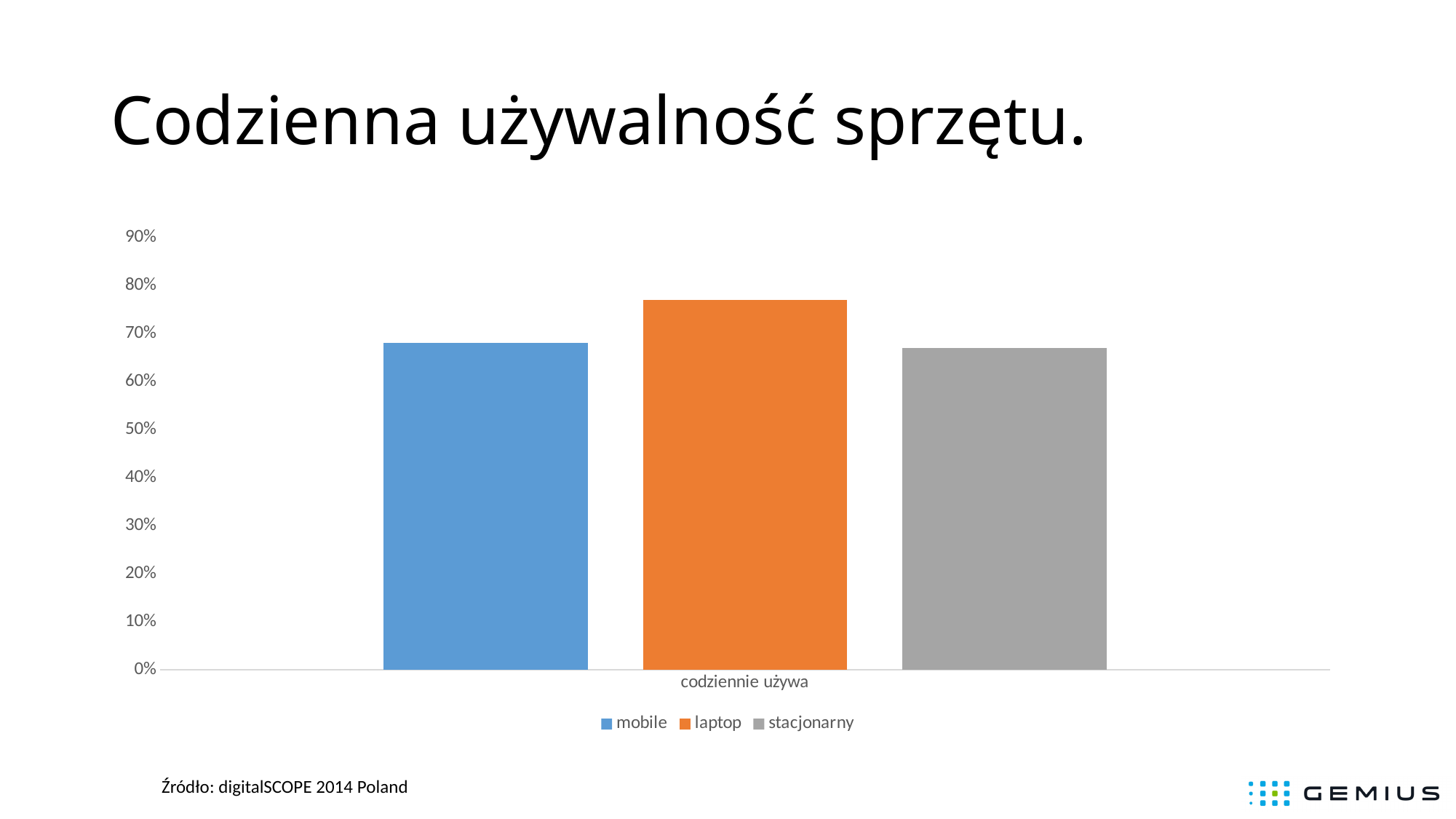
Is the value for stacjonarny greater or less than 50%? greater Is the value for laptop greater or less than 70%? greater Which is larger, the value for laptop or the value for mobile? laptop Which is larger, the value for stacjonarny or the value for laptop? laptop Is the value for stacjonarny greater or less than 70%? less What is the category label shown on the x axis? codziennie używa What kind of chart is shown on the slide? bar chart What colour is the bar for laptop? orange How many series does the legend list? 3 Which series has the highest value for 'codziennie używa'? laptop